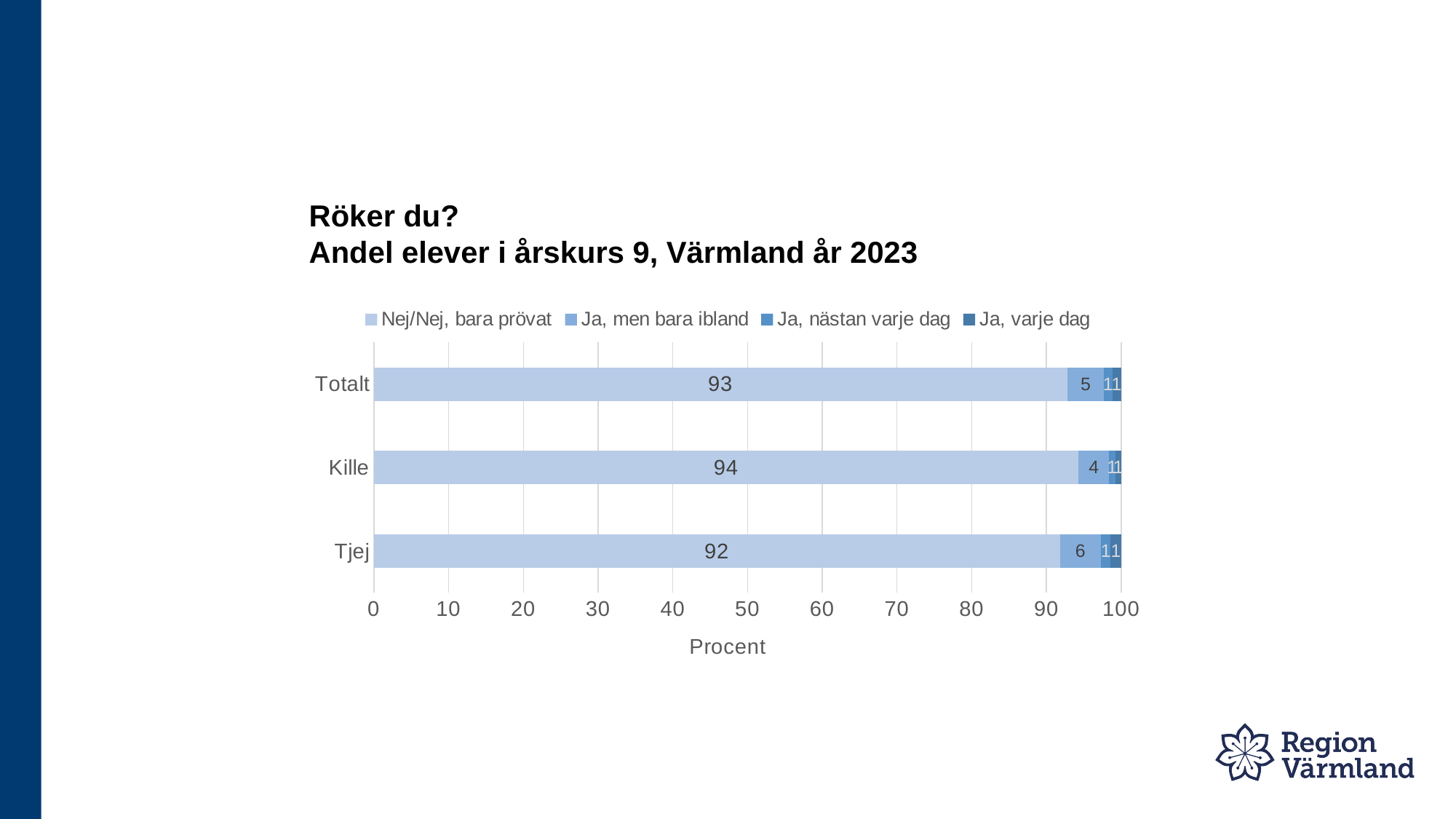
What is the label of the horizontal axis? Procent Which is larger: the 'Nej/Nej, bara prövat' value for Tjej or for Totalt? Totalt Which category has the lowest value for 'Nej/Nej, bara prövat'? Tjej What is the difference between the 'Ja, men bara ibland' values for Tjej and Kille? 2 How many series does the legend list? 4 What is the value for 'Nej/Nej, bara prövat' for Kille? 94 How many categories are shown on the vertical axis? 3 What is the value for 'Nej/Nej, bara prövat' for Totalt? 93 What kind of chart is shown on the slide? Stacked bar chart What is the value for 'Ja, men bara ibland' for Kille? 4 What is the value for 'Ja, men bara ibland' for Tjej? 6 Which category has the highest value for 'Nej/Nej, bara prövat'? Kille